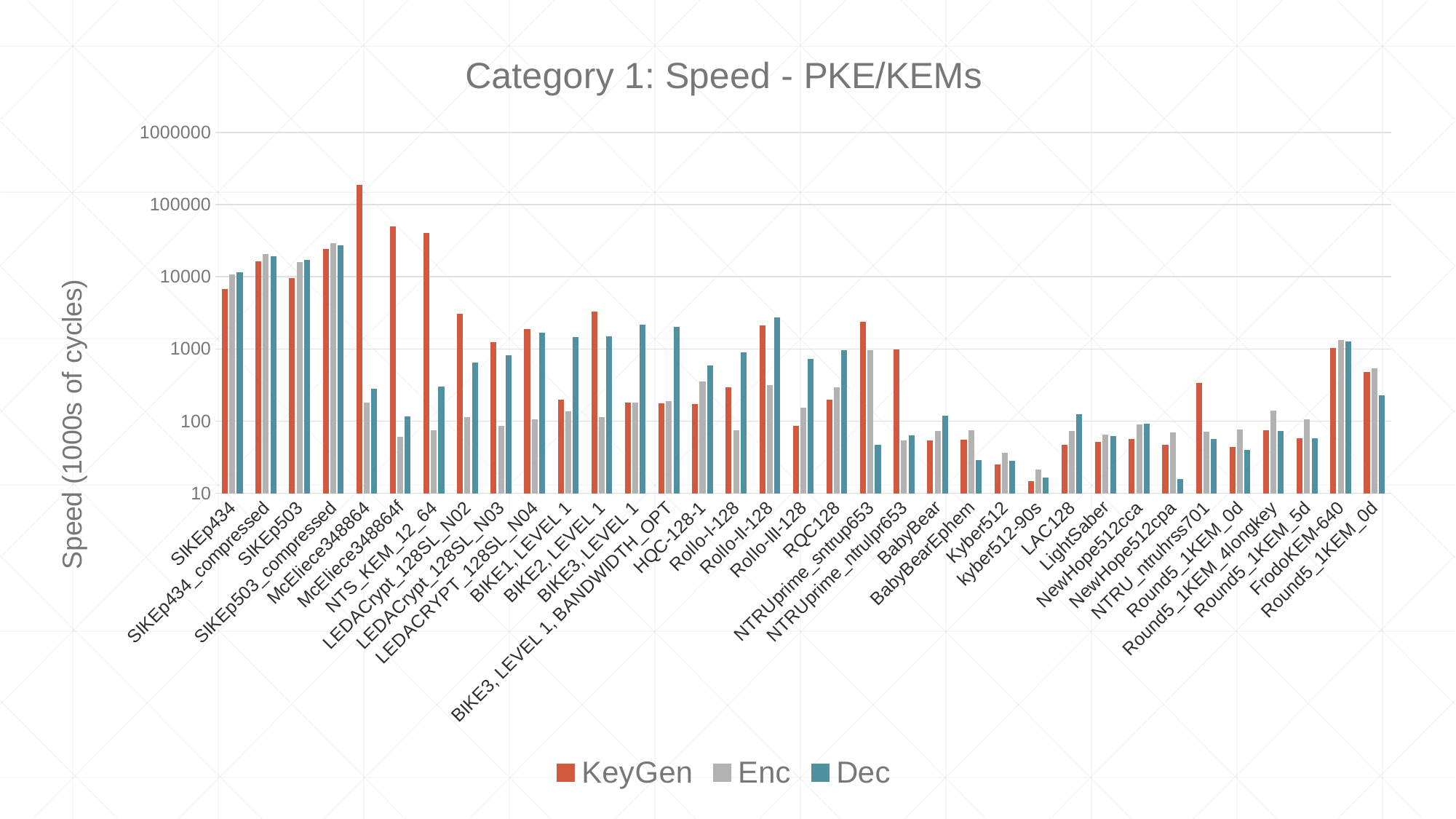
Is the KeyGen value for McEliece348864 greater or less than 100000? greater Is the KeyGen value for NTS_KEM_12_64 greater or less than 10000? greater Is the Enc value for FrodoKEM-640 greater or less than 1000? greater For SIKEp434, which is larger, the KeyGen value or the Dec value? Dec Which scheme has the lowest KeyGen value? kyber512-90s Which scheme has the highest KeyGen value? McEliece348864 What is the label of the vertical axis? Speed (1000s of cycles) What kind of chart is shown on the slide? bar chart What is the title of the chart? Category 1: Speed - PKE/KEMs Which scheme has the lowest Dec value? NewHope512cpa How many series does the legend list? 3